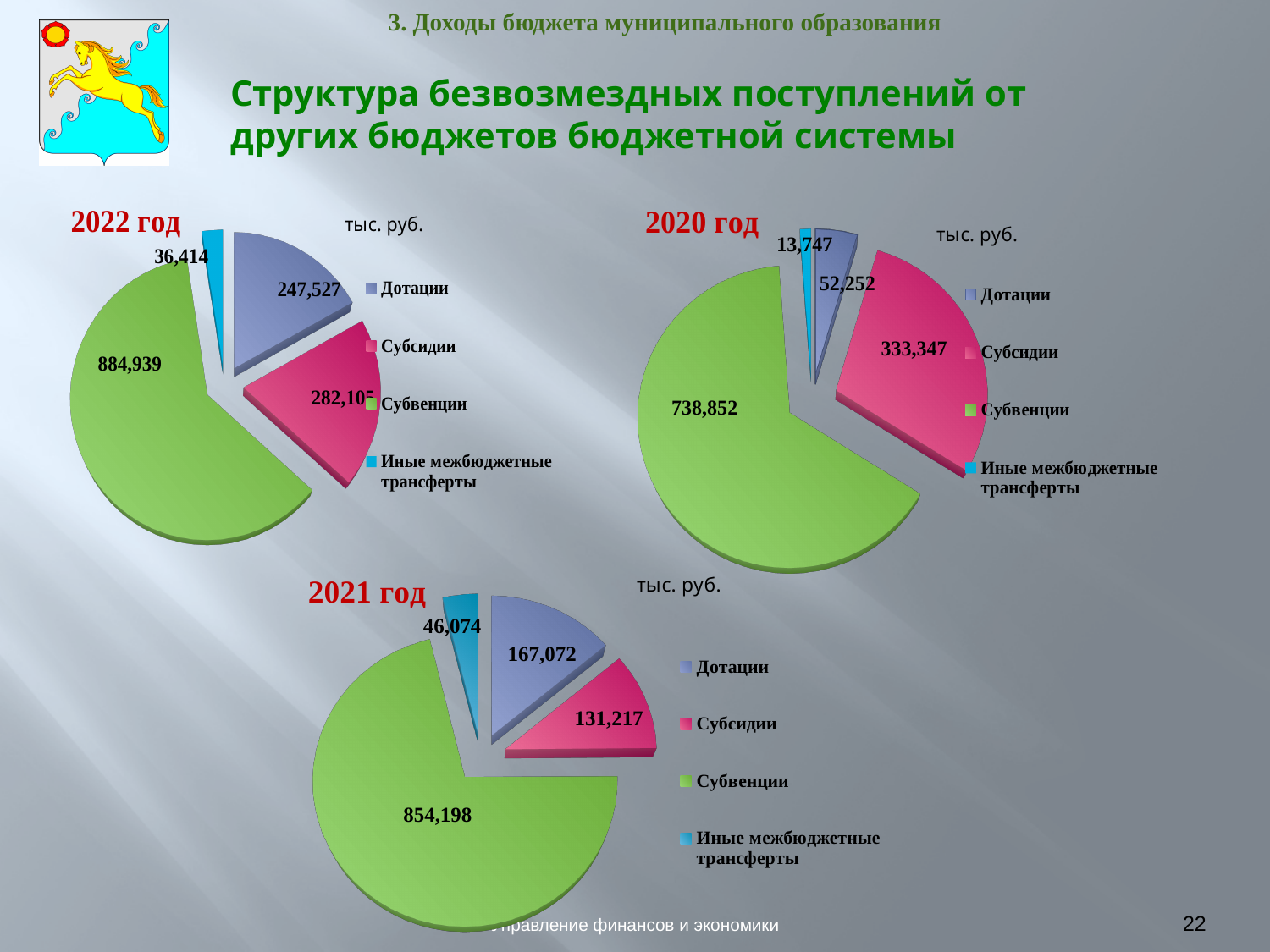
In the 2022 год chart, what is the value for Дотации? 247,527 In the 2020 год chart, which category has the smallest slice? Иные межбюджетные трансферты In the 2021 год chart, which category has the largest slice? Субвенции In the 2022 год chart, what is the value for Иные межбюджетные трансферты? 36,414 In the 2020 год chart, what is the difference between Субвенции and Субсидии? 405,505 What type of chart is used for the 2022 год data? Pie chart In the 2021 год chart, what is the total of all four slices? 1,198,561 How many categories does the legend of the 2020 год chart list? 4 In the 2021 год chart, which is larger, Дотации or Субсидии? Дотации In the 2022 год chart, what is the value for Субвенции? 884,939 In the 2021 год chart, what is the value for Субсидии? 131,217 In the 2020 год chart, what is the value for Субсидии? 333,347